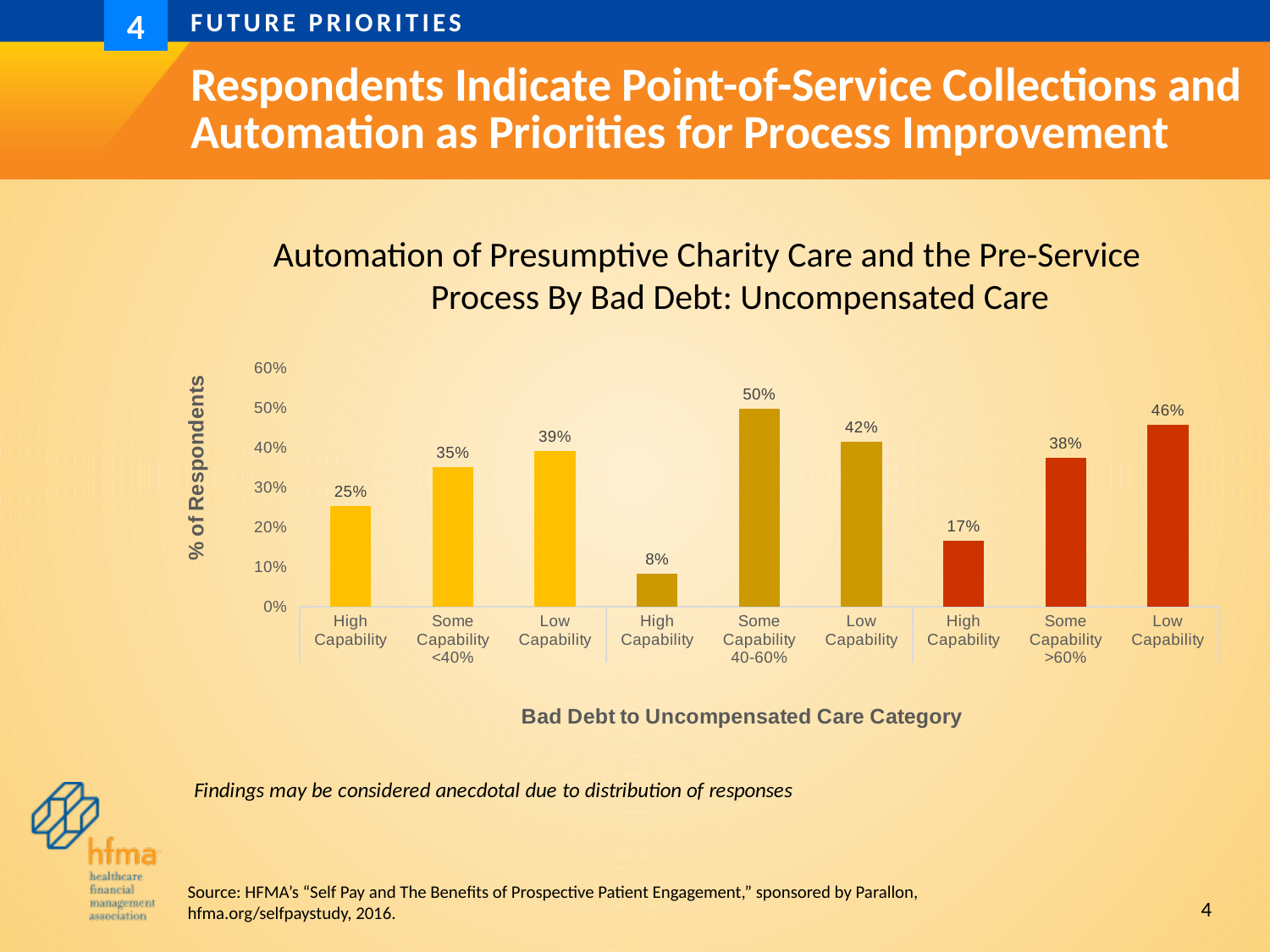
How many bars are plotted on the chart? 9 Which is larger: Low Capability in the <40% group or Low Capability in the 40-60% group? Low Capability in the 40-60% group Which bar has the lowest value on the chart? High Capability, 40-60% What is the value for Some Capability in the 40-60% bad debt group? 50% Do the values rise or fall from High Capability to Low Capability within the >60% bad debt group? Rise What is the value for Low Capability in the >60% bad debt group? 46% What kind of chart is shown on the slide? Bar chart What is the difference between Low Capability and High Capability in the >60% bad debt group? 29% What is the value for High Capability in the 40-60% bad debt group? 8% What percentage of respondents is shown for High Capability in the <40% bad debt group? 25% Which bar has the highest value on the chart? Some Capability, 40-60% What is the label of the vertical axis? % of Respondents